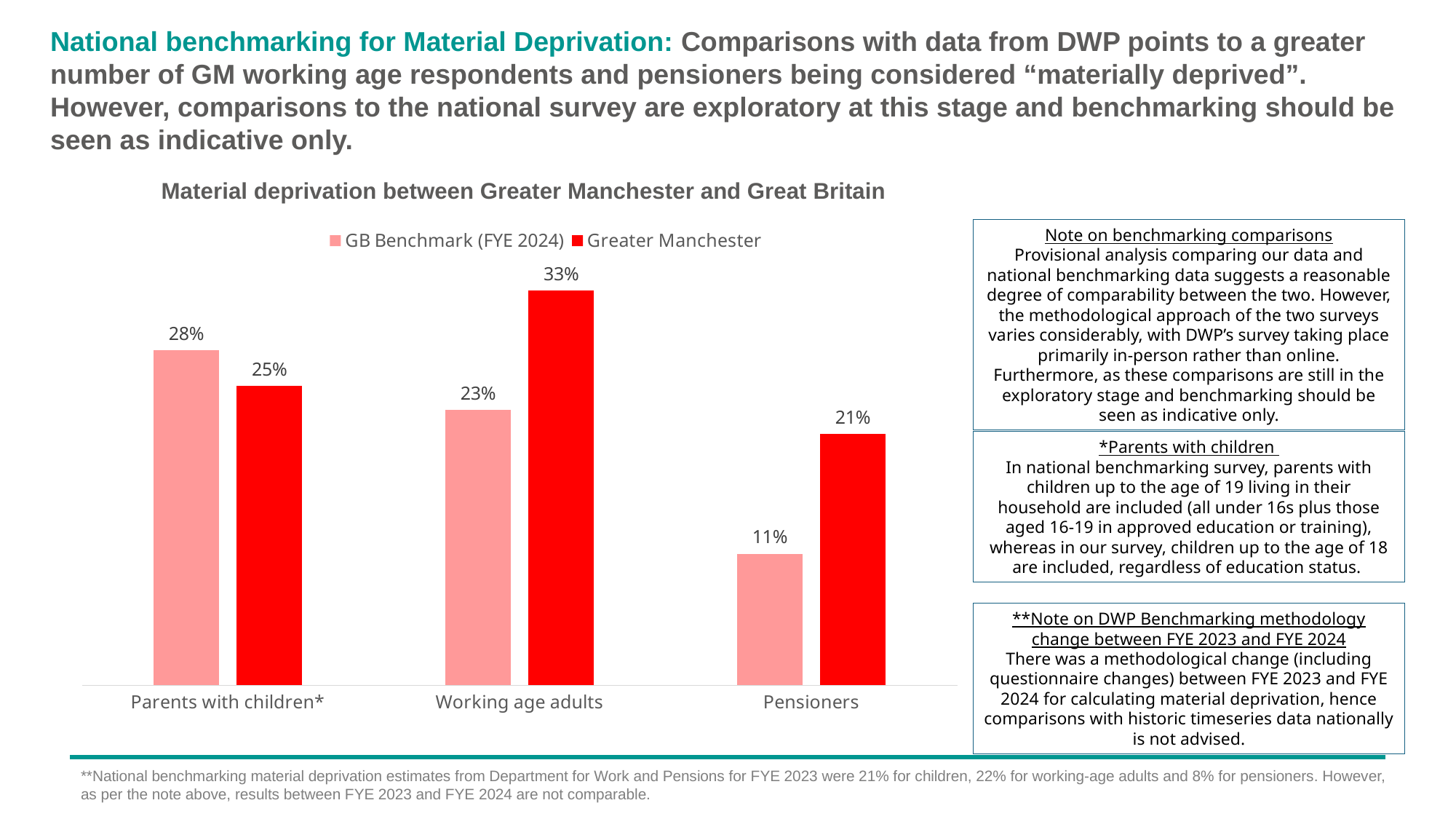
What is the difference between the Greater Manchester and GB Benchmark (FYE 2024) values for Working age adults? 10 percentage points What is the title of the chart? Material deprivation between Greater Manchester and Great Britain Which category has the highest Greater Manchester value? Working age adults What is the Greater Manchester value for Working age adults? 33% How many series does the legend list? 2 How many categories are shown on the x axis? 3 Which category has the lowest GB Benchmark (FYE 2024) value? Pensioners What is the Greater Manchester value for Pensioners? 21% What kind of chart is shown on the slide? Bar chart For Parents with children*, which is larger: the GB Benchmark (FYE 2024) value or the Greater Manchester value? GB Benchmark (FYE 2024) What is the GB Benchmark (FYE 2024) value for Parents with children*? 28% What is the GB Benchmark (FYE 2024) value for Pensioners? 11%